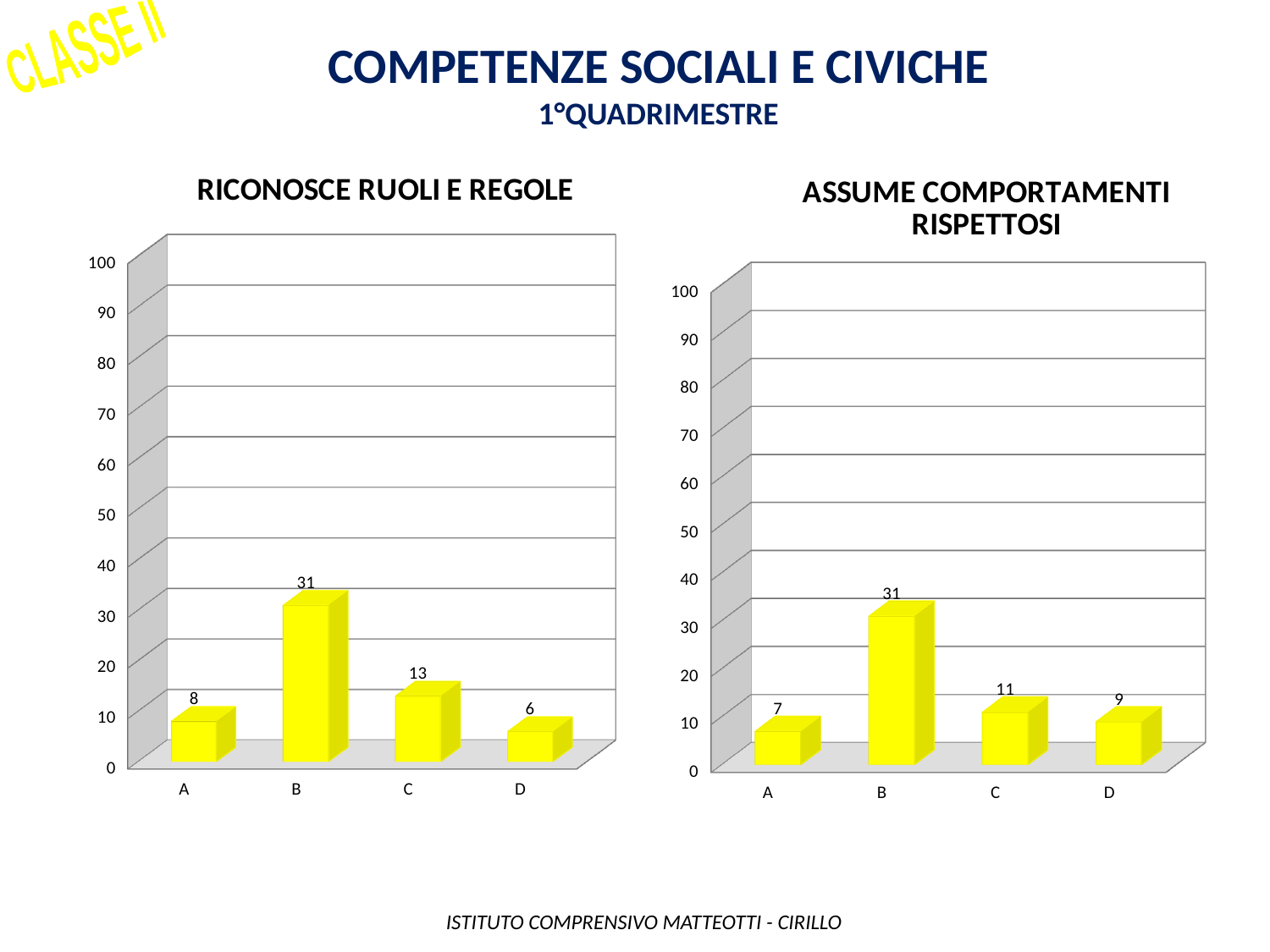
In the 'RICONOSCE RUOLI E REGOLE' chart, which category has the lowest value? D In the 'RICONOSCE RUOLI E REGOLE' chart, what is the difference between the values for B and C? 18 In the 'ASSUME COMPORTAMENTI RISPETTOSI' chart, which is larger, the value for C or the value for D? C In the 'RICONOSCE RUOLI E REGOLE' chart, what is the value for category B? 31 How many categories are shown in the 'RICONOSCE RUOLI E REGOLE' chart? 4 In the 'ASSUME COMPORTAMENTI RISPETTOSI' chart, what is the value for category D? 9 In the 'ASSUME COMPORTAMENTI RISPETTOSI' chart, what is the difference between the values for C and D? 2 In the 'ASSUME COMPORTAMENTI RISPETTOSI' chart, what is the value for category A? 7 What type of chart is the 'ASSUME COMPORTAMENTI RISPETTOSI' chart? Bar chart In the 'RICONOSCE RUOLI E REGOLE' chart, which category has the highest value? B In the 'RICONOSCE RUOLI E REGOLE' chart, what is the value for category C? 13 In the 'ASSUME COMPORTAMENTI RISPETTOSI' chart, which category has the lowest value? A